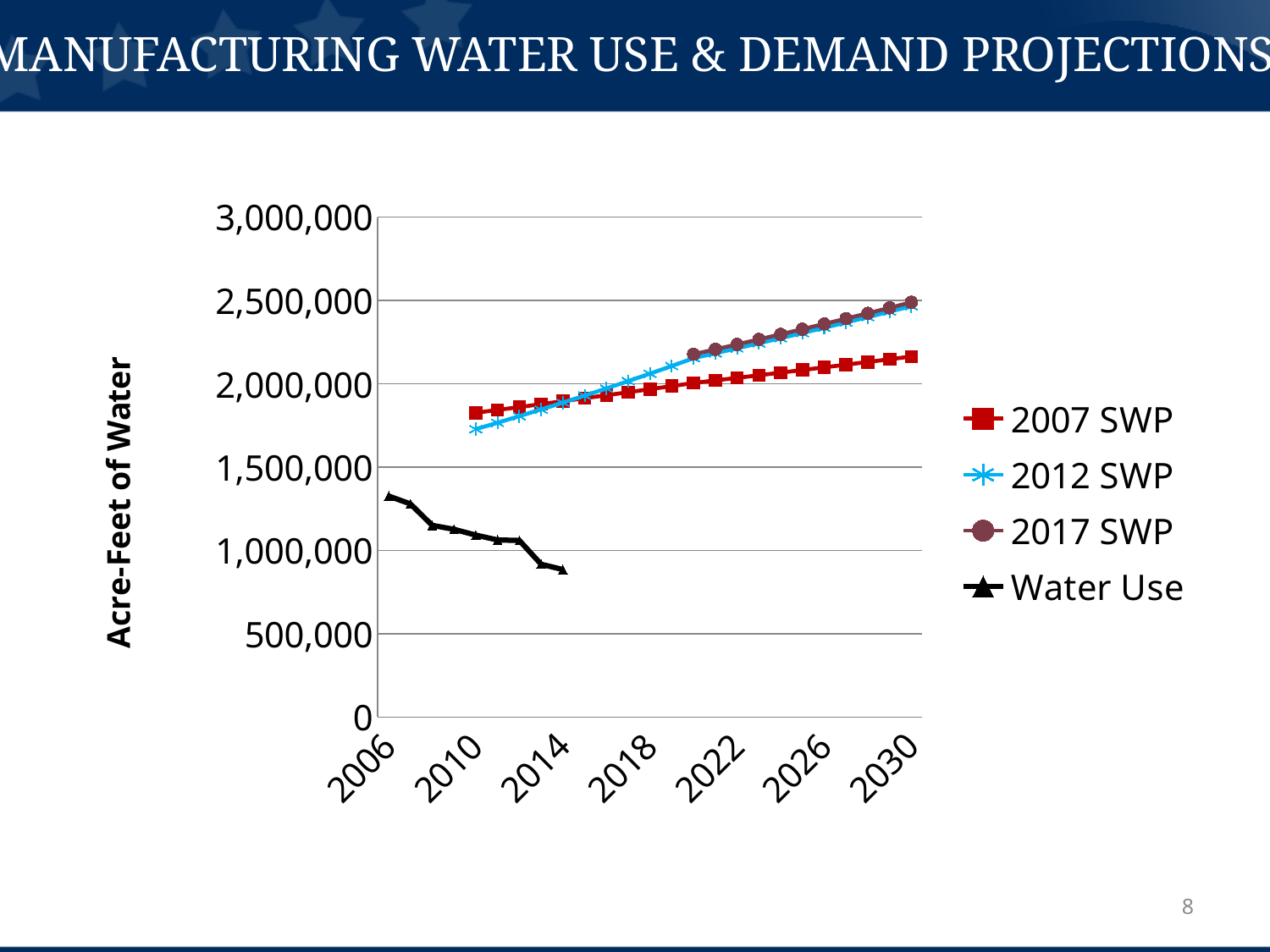
What is the label on the vertical axis? Acre-Feet of Water How many series does the legend list? 4 Is the Water Use value in 2006 greater or less than 1,500,000? less Does the Water Use series rise or fall from 2006 to 2014? fall Which series has the lowest values on the chart? Water Use Is the Water Use value in 2014 greater or less than 1,000,000? less What kind of chart is shown on the slide? line chart Which series are listed in the legend? 2007 SWP, 2012 SWP, 2017 SWP, Water Use In 2030, which series is higher, 2007 SWP or 2017 SWP? 2017 SWP Does the 2007 SWP series rise or fall from 2010 to 2030? rise Is the 2007 SWP value in 2030 greater or less than 2,500,000? less